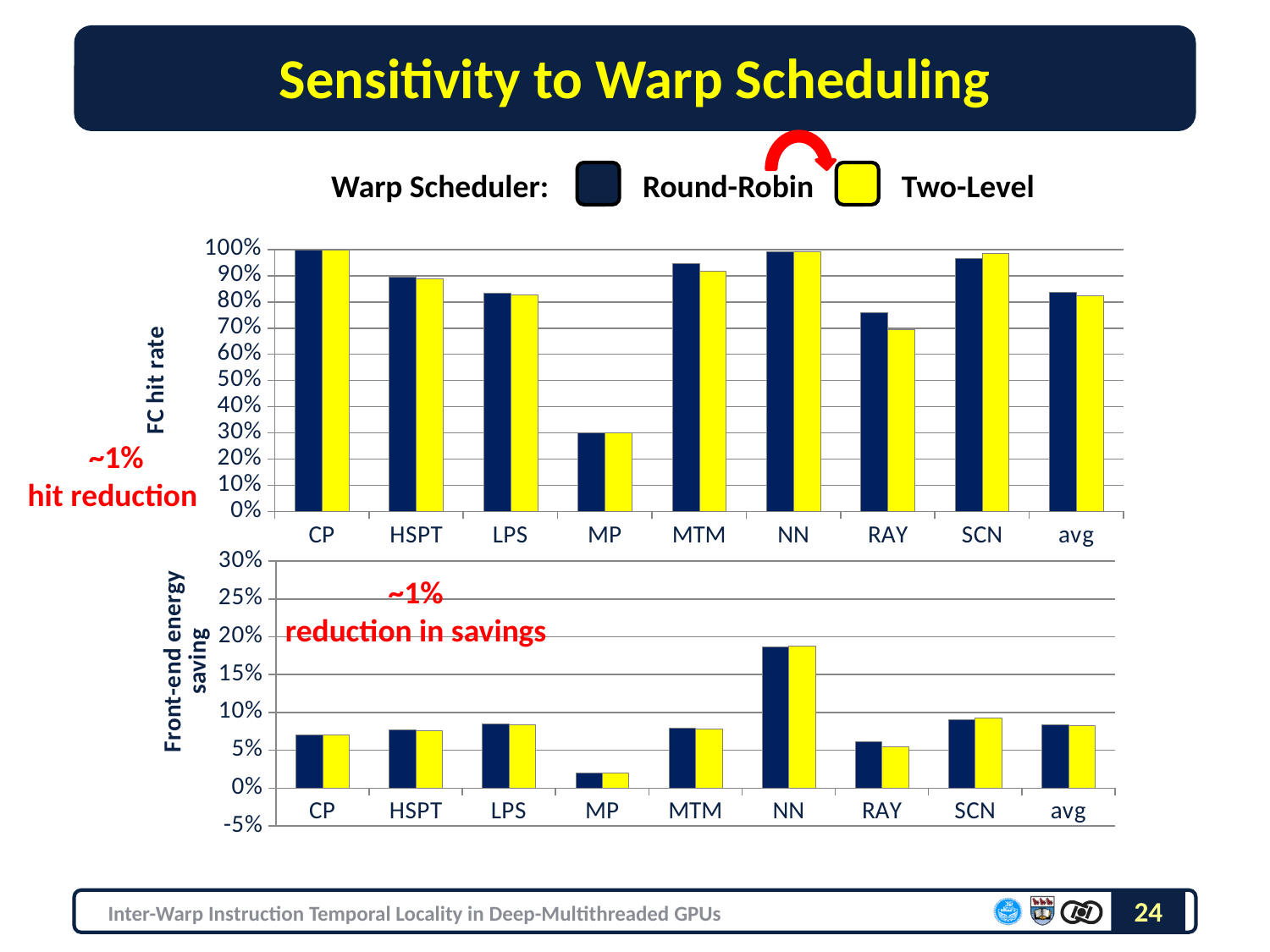
In the bottom chart (Front-end energy saving), is the Two-Level value for NN greater or less than 15%? greater What colour represents the Two-Level warp scheduler in the legend? yellow What kind of chart is the top chart (FC hit rate)? bar chart In the top chart (FC hit rate), is the Round-Robin value for MP greater or less than 40%? less In the bottom chart (Front-end energy saving), which category has the lowest energy saving? MP In the top chart (FC hit rate), which category has the lowest hit rate? MP How many series does the legend list for the charts? 2 In the bottom chart (Front-end energy saving), which category has the highest energy saving? NN In the bottom chart (Front-end energy saving), is the Round-Robin value for MP greater or less than 5%? less In the top chart (FC hit rate), which is larger for RAY: Round-Robin or Two-Level? Round-Robin How many categories are shown on the x axis of the bottom chart (Front-end energy saving)? 9